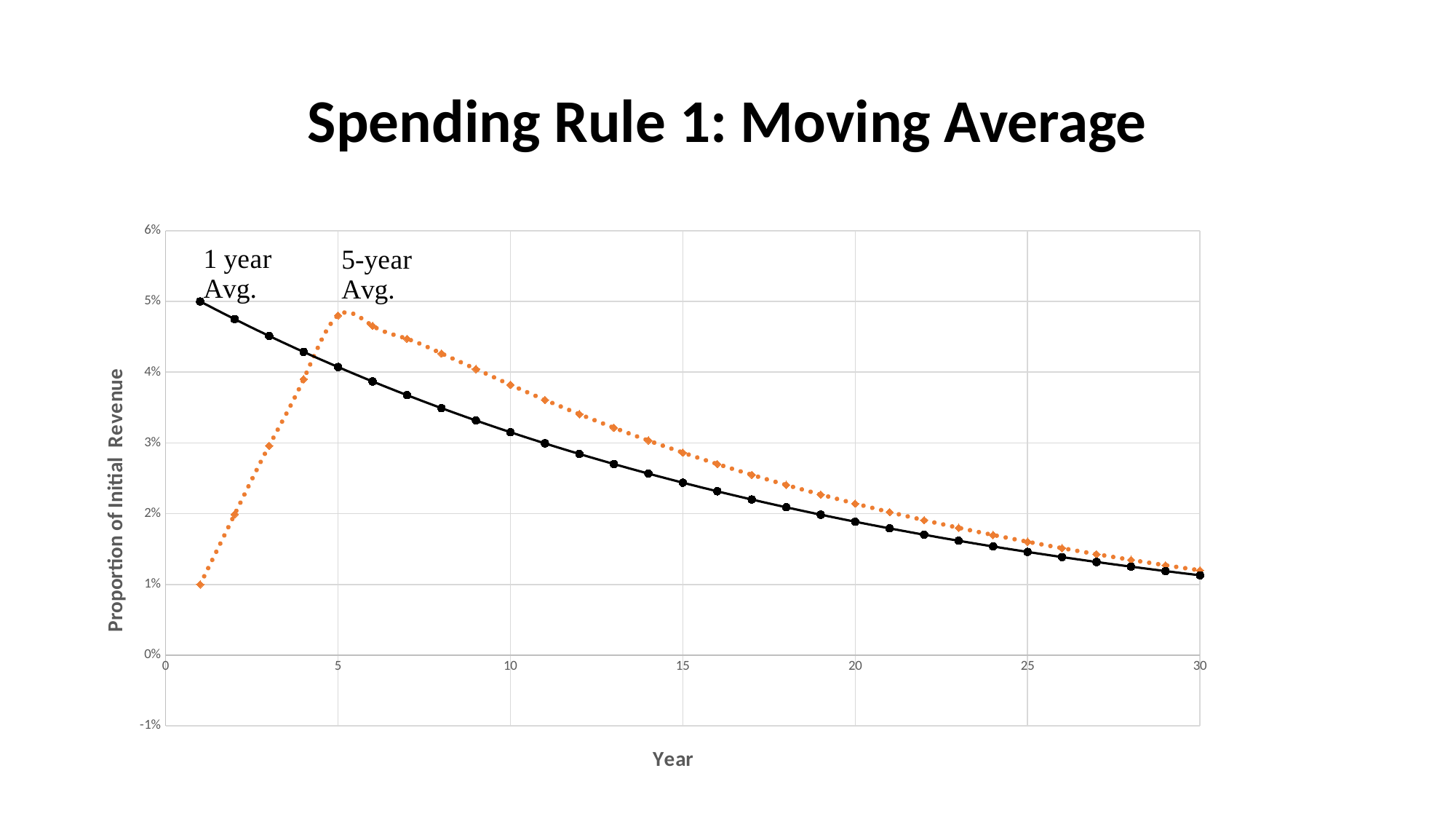
What is the difference between the 1 year Avg. and the 5-year Avg. at year 1? 4 percentage points Is the value of the 5-year Avg. series at year 10 greater or less than 3%? greater At year 3, which series has the higher value, 1 year Avg. or 5-year Avg.? 1 year Avg. At year 10, which series has the higher value, 1 year Avg. or 5-year Avg.? 5-year Avg. How many data series are plotted on the chart? 2 What is the value of the 1 year Avg. series at year 1? 5% Is the value of the 5-year Avg. series at year 5 greater or less than 5%? less Is the value of the 1 year Avg. series at year 15 greater or less than 3%? less What kind of chart is shown on the slide? line chart What is the value of the 5-year Avg. series at year 1? 1% Does the 1 year Avg. series rise or fall as the year increases? fall What is the title of the x axis? Year